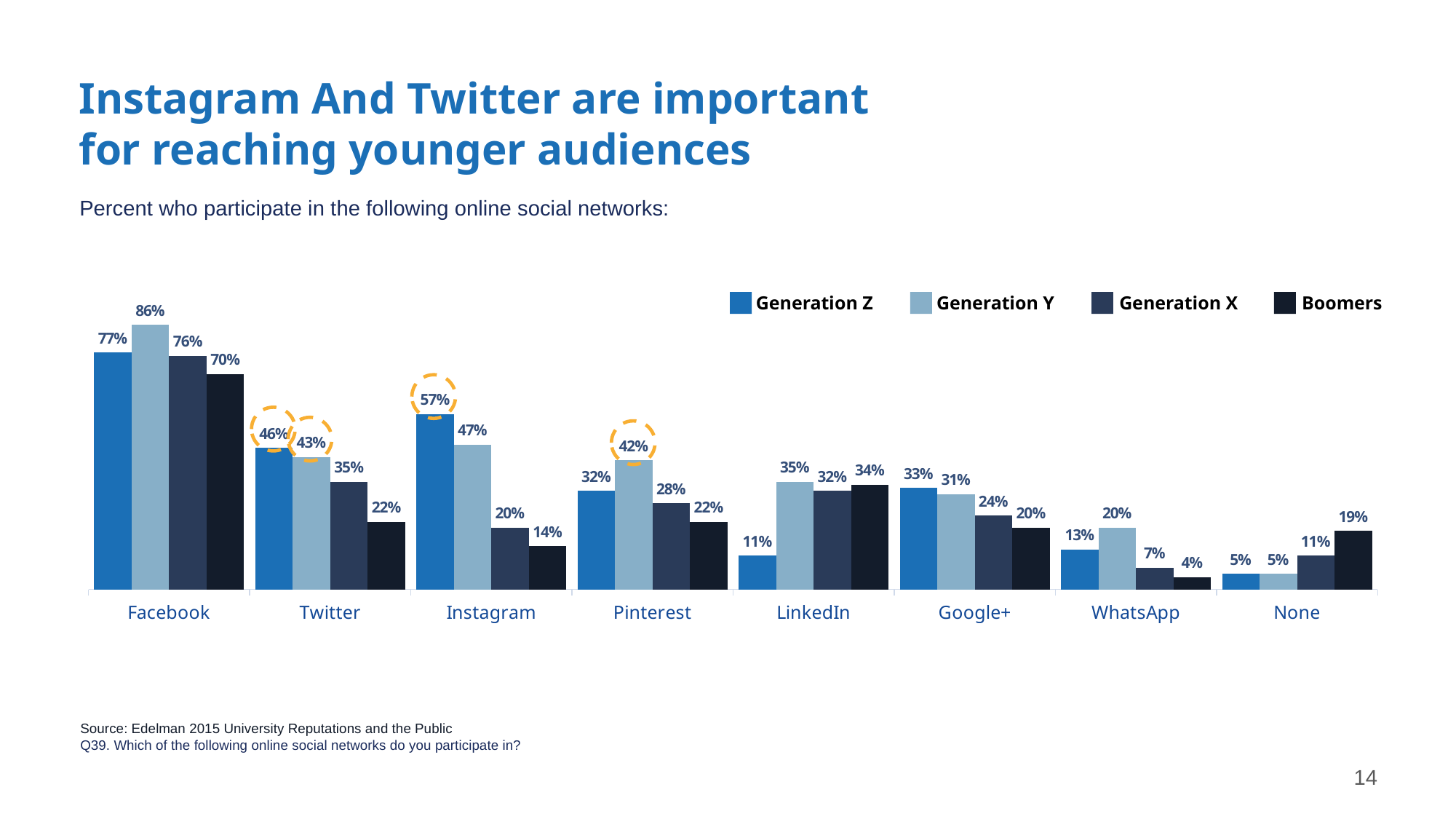
How many series does the legend list? 4 Which is larger: Generation Y participation in Pinterest or Generation X participation in Pinterest? Generation Y Which social network has the lowest participation among Generation X? WhatsApp What percentage of Generation Z participate in LinkedIn? 11% Which generation has the highest participation in LinkedIn? Generation Y What percentage of Boomers participate in Instagram? 14% Which social network has the highest participation among Generation Z? Facebook How many social network categories are shown on the x axis? 8 Which legend entry is shown in the lightest blue colour? Generation Y What is the difference between Generation Z and Boomers participation in Instagram? 43 percentage points What percentage of Generation Y participate in Facebook? 86% What kind of chart is shown on the slide? Bar chart